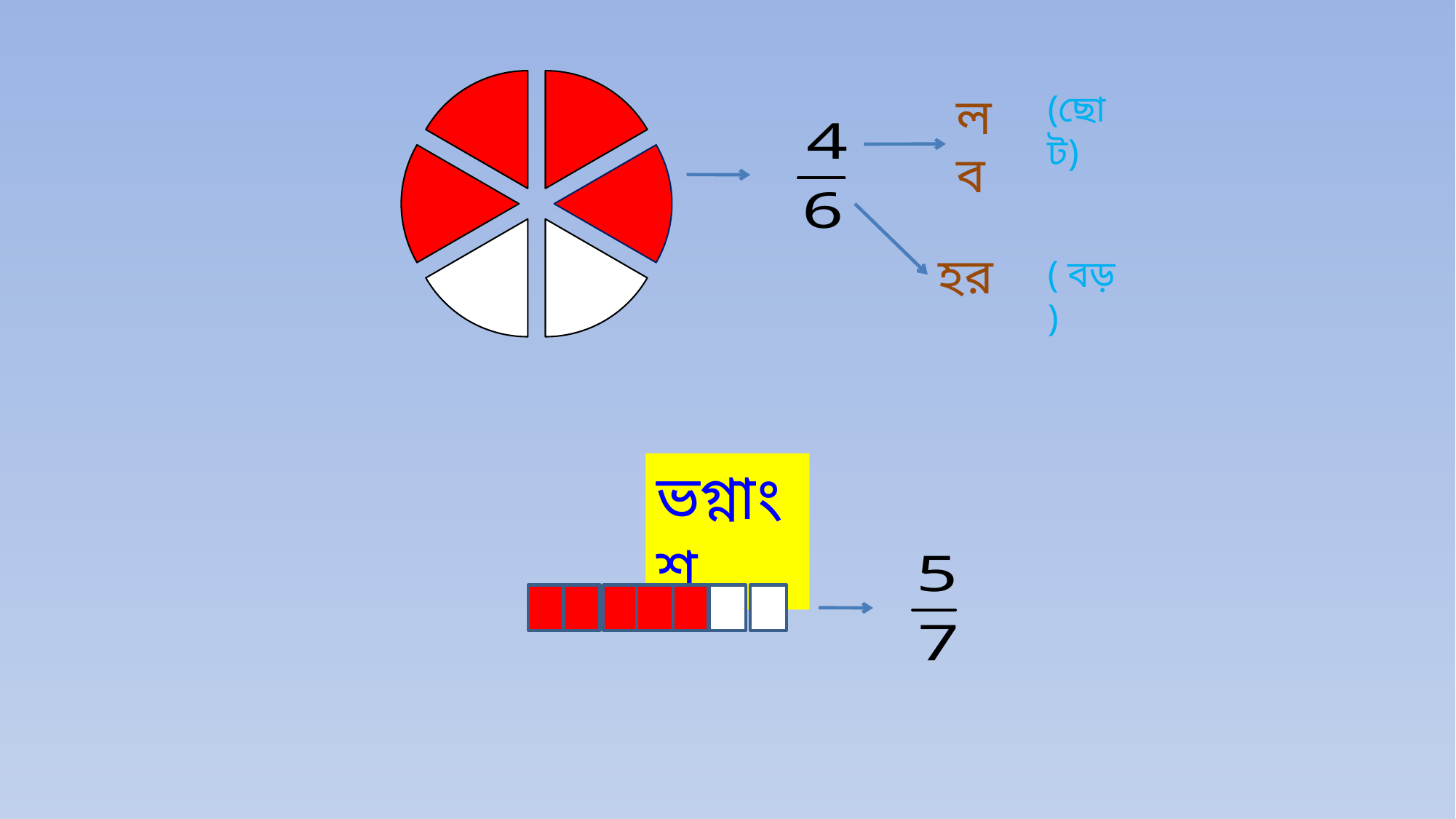
In the row of squares at the bottom, how many squares are white? 2 In the circle diagram at the top, how many equal slices is the circle divided into? 6 In the circle diagram at the top, how many slices are shaded red? 4 What fraction is written to the right of the row of squares? 5/7 Which diagram has more red parts, the circle at the top or the row of squares at the bottom? the row of squares What fraction is written to the right of the circle diagram? 4/6 What colour are the shaded parts in both diagrams? red What is the denominator of the fraction shown next to the circle diagram? 6 What is the numerator of the fraction shown next to the circle diagram? 4